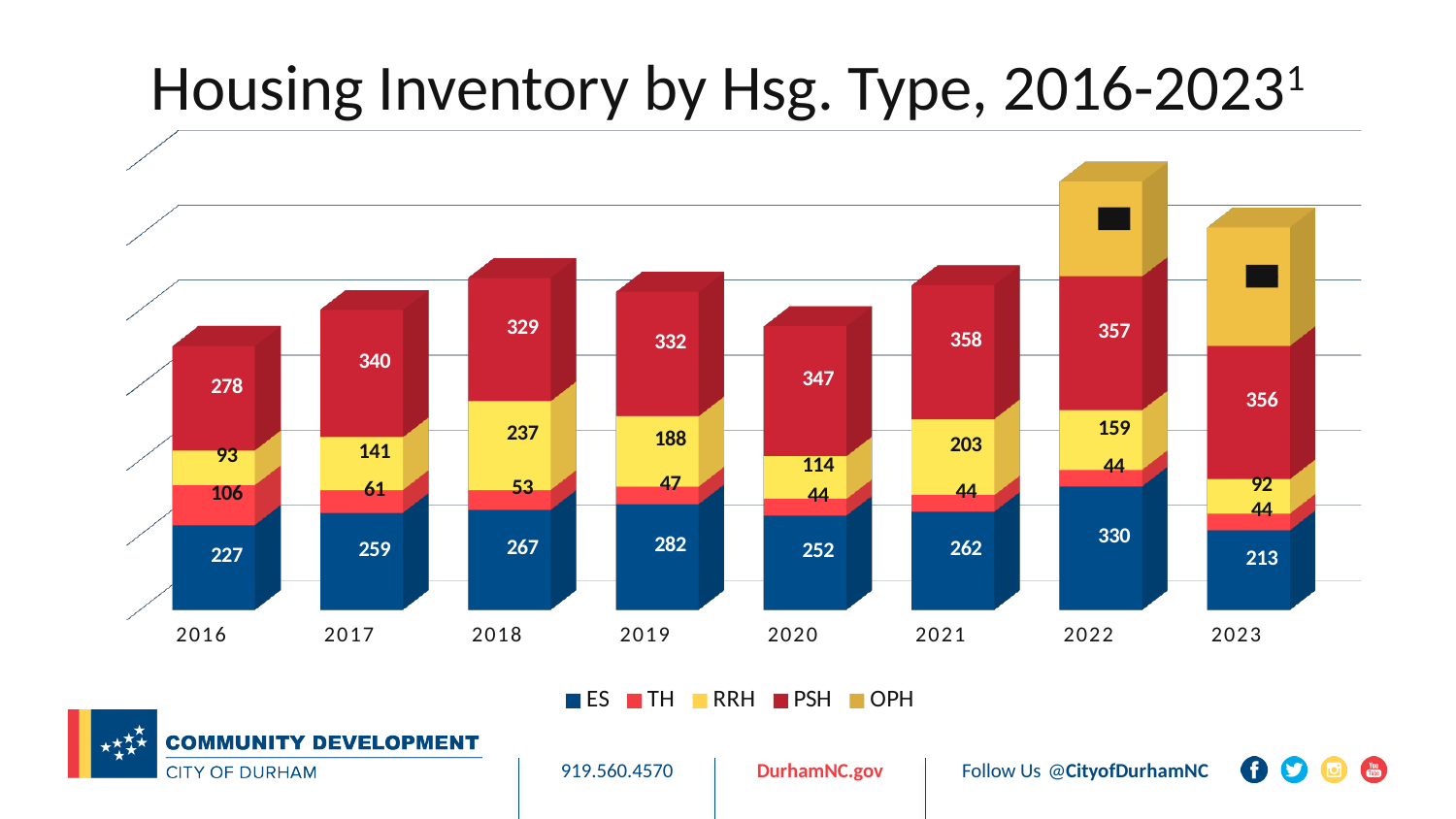
What is the ES value for 2019? 282 What is the TH value for 2016? 106 How many series does the legend list? 5 How many years are shown on the x axis? 8 What is the difference between the ES values for 2022 and 2023? 117 Which year has the highest RRH value? 2018 Which year has the highest ES value? 2022 What is the PSH value for 2017? 340 Which year has the lowest ES value? 2023 What is the RRH value for 2022? 159 What is the total of the stacked bar for 2016? 704 Is the RRH value larger in 2021 or in 2020? 2021